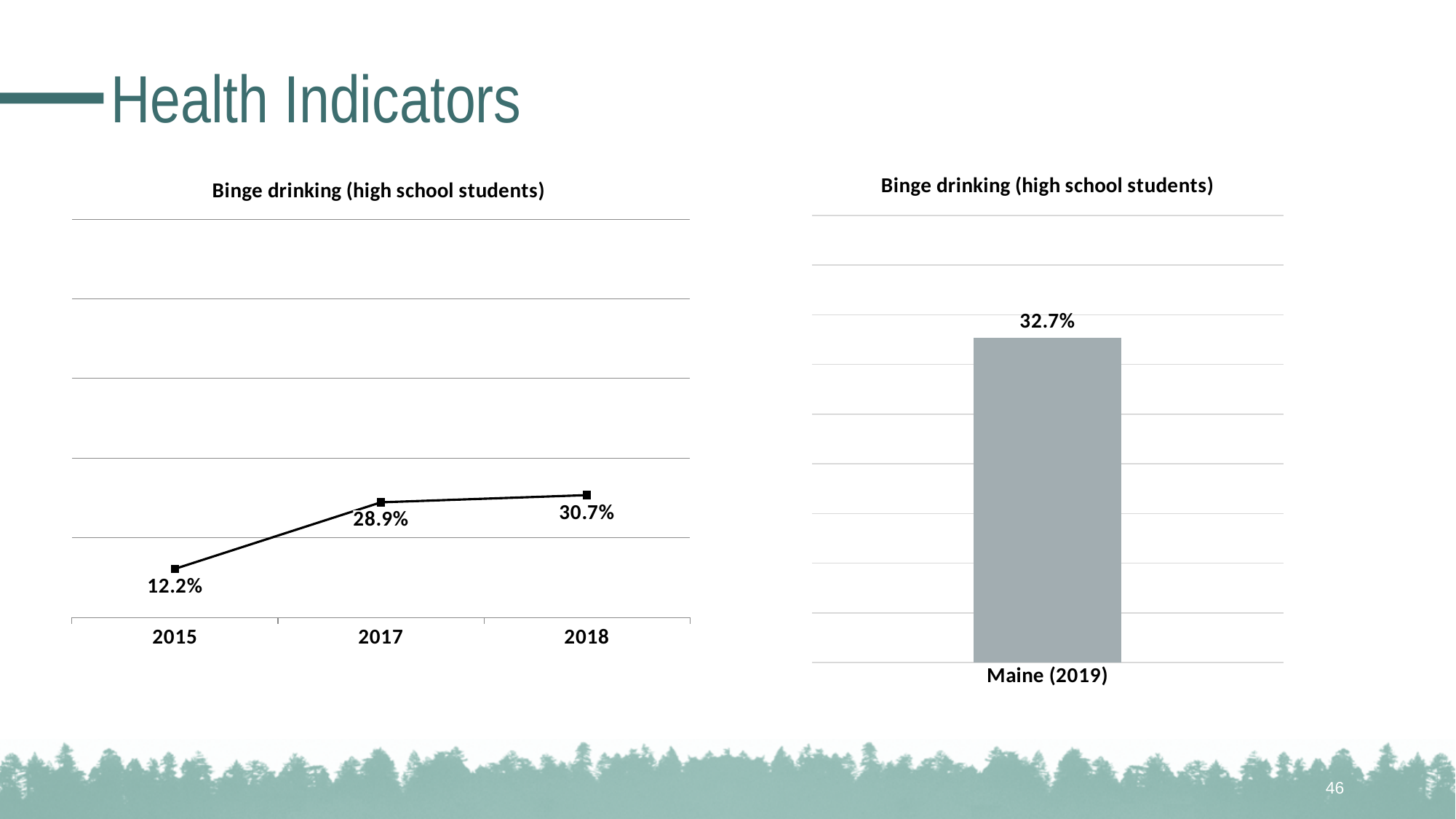
In the left chart, what is the binge drinking value for 2015? 12.2% What kind of chart is the right chart? bar chart In the right chart, what is the binge drinking value for Maine (2019)? 32.7% In the left chart, what is the difference between the 2018 and 2017 values? 1.8% In the left chart, what is the binge drinking value for 2017? 28.9% In the left chart, what is the binge drinking value for 2018? 30.7% How many data points are plotted in the left chart? 3 In the left chart, which year has the highest binge drinking value? 2018 In the left chart, is the value for 2017 larger or smaller than the value for 2015? larger In the left chart, which year has the lowest binge drinking value? 2015 In the left chart, do the values rise or fall from 2015 to 2018? rise In the left chart, what is the difference between the 2017 and 2015 values? 16.7%